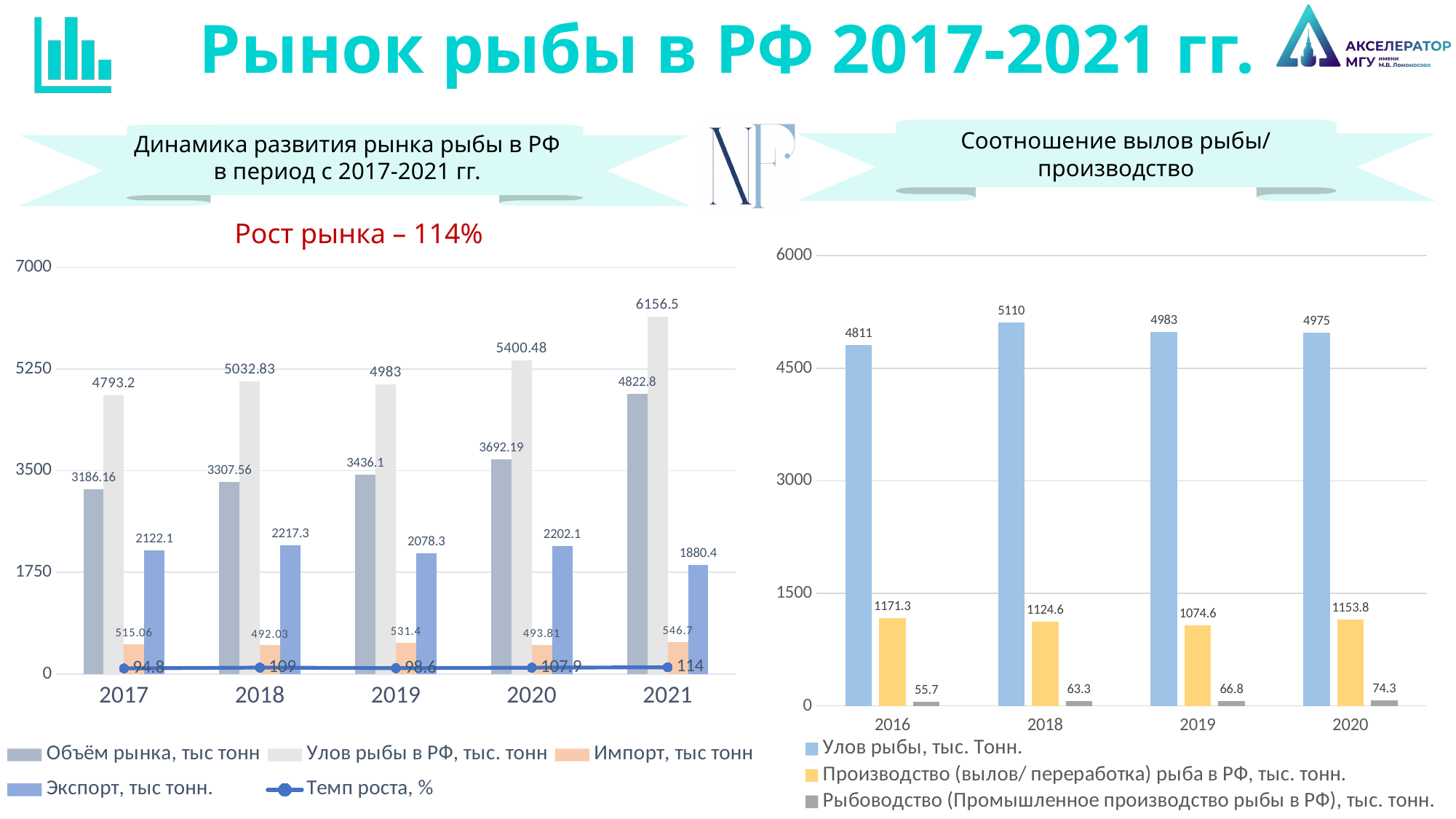
In the left chart (Динамика развития рынка рыбы в РФ), which year has the highest Экспорт, тыс тонн value? 2018 In the left chart (Динамика развития рынка рыбы в РФ), how many series does the legend list? 5 In the left chart (Динамика развития рынка рыбы в РФ), what is the Темп роста, % value for 2017? 94.8 In the left chart (Динамика развития рынка рыбы в РФ), which year has the lowest Импорт, тыс тонн value? 2018 In the left chart (Динамика развития рынка рыбы в РФ), does Объём рынка rise or fall from 2017 to 2021? rise In the right chart (Соотношение вылов рыбы/производство), which year has the highest Рыбоводство value? 2020 In the left chart (Динамика развития рынка рыбы в РФ), what is the value of Улов рыбы в РФ, тыс. тонн for 2021? 6156.5 In the left chart (Динамика развития рынка рыбы в РФ), what is the difference between Объём рынка in 2021 and in 2020? 1130.61 In the right chart (Соотношение вылов рыбы/производство), what is the value of Улов рыбы, тыс. Тонн for 2018? 5110 In the right chart (Соотношение вылов рыбы/производство), is Производство in 2016 larger or smaller than in 2019? larger In the right chart (Соотношение вылов рыбы/производство), how many years are shown on the x axis? 4 In the left chart (Динамика развития рынка рыбы в РФ), what is the value of Объём рынка, тыс тонн for 2019? 3436.1